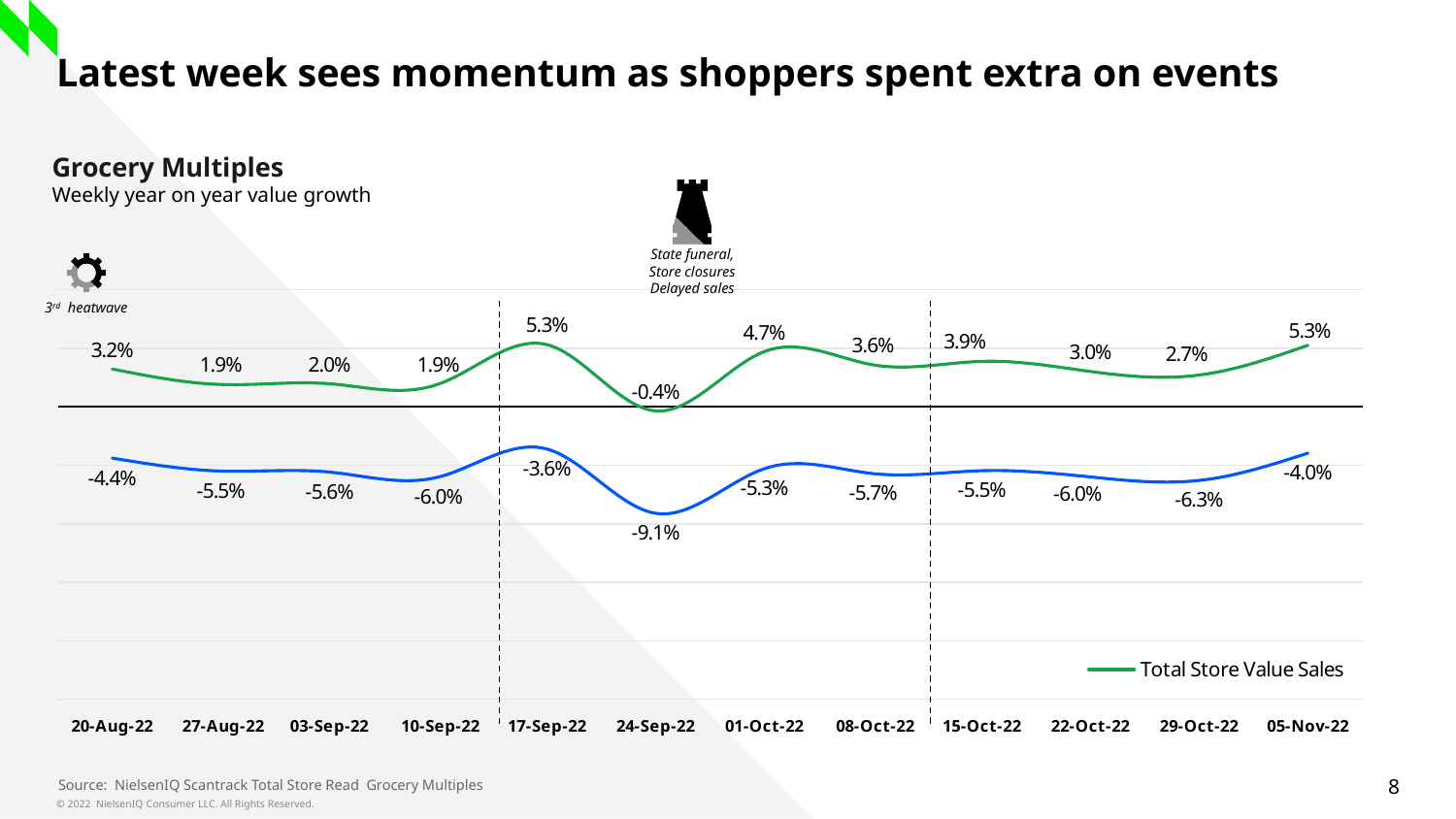
What is the difference between the Total Store Value Sales growth for 01-Oct-22 and 24-Sep-22? 5.1 percentage points What is the Total Store Value Sales growth for 05-Nov-22? 5.3% What is the Total Store Value Sales growth for 01-Oct-22? 4.7% What type of chart is shown on the slide? line chart How many series does the legend list? 1 What is the Total Store Value Sales growth for 20-Aug-22? 3.2% What is the Total Store Value Sales growth for 24-Sep-22? -0.4% How many weeks are plotted on the x axis? 12 What is the value of the blue line at 24-Sep-22? -9.1% What is the subtitle shown under 'Grocery Multiples' on the chart? Weekly year on year value growth Which week has the higher Total Store Value Sales growth, 15-Oct-22 or 22-Oct-22? 15-Oct-22 Which week has the lowest Total Store Value Sales growth? 24-Sep-22